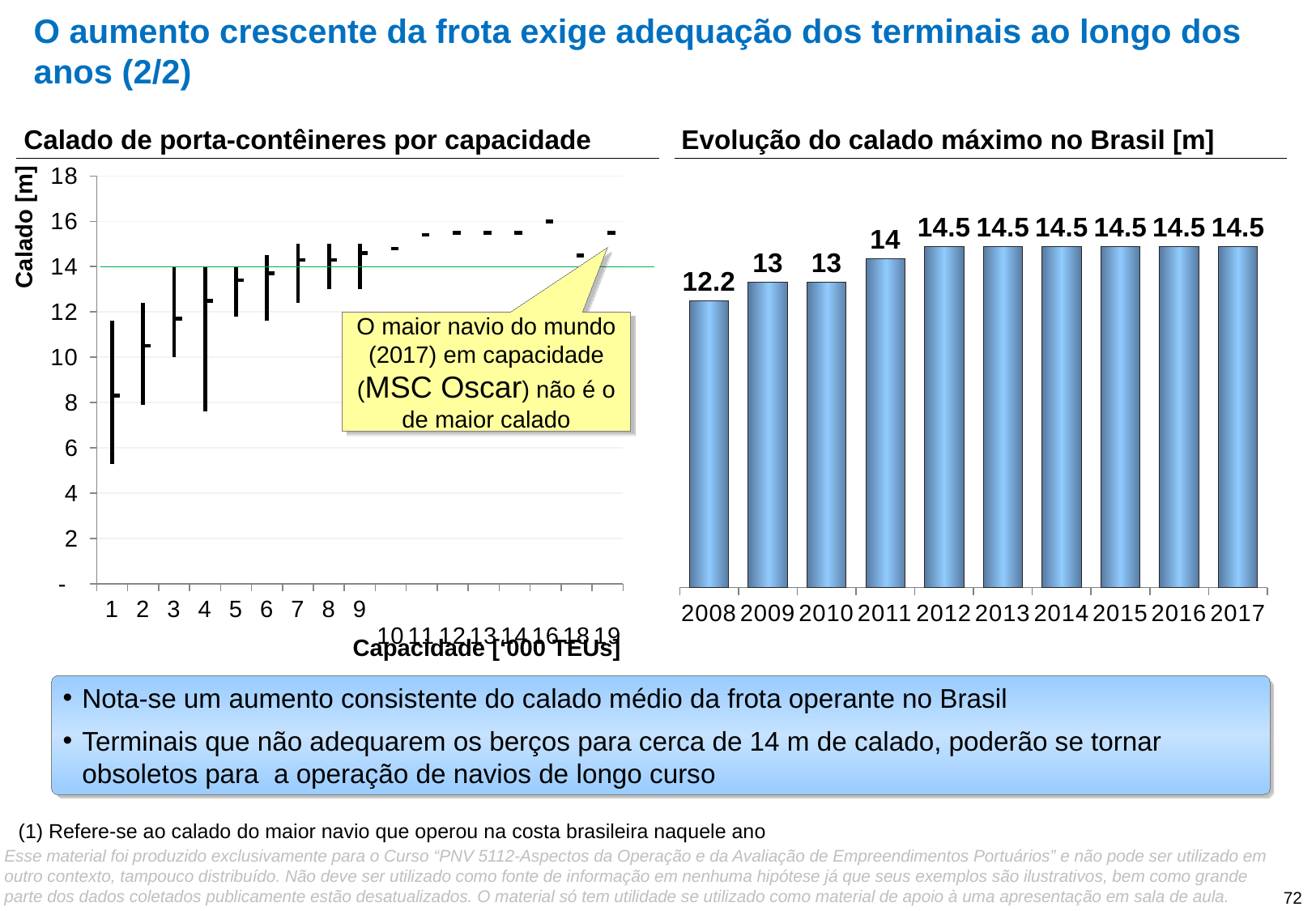
What kind of chart is 'Evolução do calado máximo no Brasil [m]'? bar chart In the chart 'Evolução do calado máximo no Brasil [m]', do the values rise or fall from 2008 to 2017? rise In the chart 'Calado de porta-contêineres por capacidade', is the value for capacity 19 greater or less than 14? greater In the chart 'Evolução do calado máximo no Brasil [m]', what is the difference between the values for 2017 and 2008? 2.3 In the chart 'Evolução do calado máximo no Brasil [m]', which year has the lowest value? 2008 In the chart 'Evolução do calado máximo no Brasil [m]', what is the value for 2011? 14 In the chart 'Evolução do calado máximo no Brasil [m]', which is larger, the value for 2009 or the value for 2011? 2011 How many years are shown in the chart 'Evolução do calado máximo no Brasil [m]'? 10 What is the y-axis label of the chart 'Calado de porta-contêineres por capacidade'? Calado [m] In the chart 'Evolução do calado máximo no Brasil [m]', what is the value for 2008? 12.2 In the chart 'Evolução do calado máximo no Brasil [m]', what is the value for 2017? 14.5 How many capacity categories are shown on the x axis of the chart 'Calado de porta-contêineres por capacidade'? 17